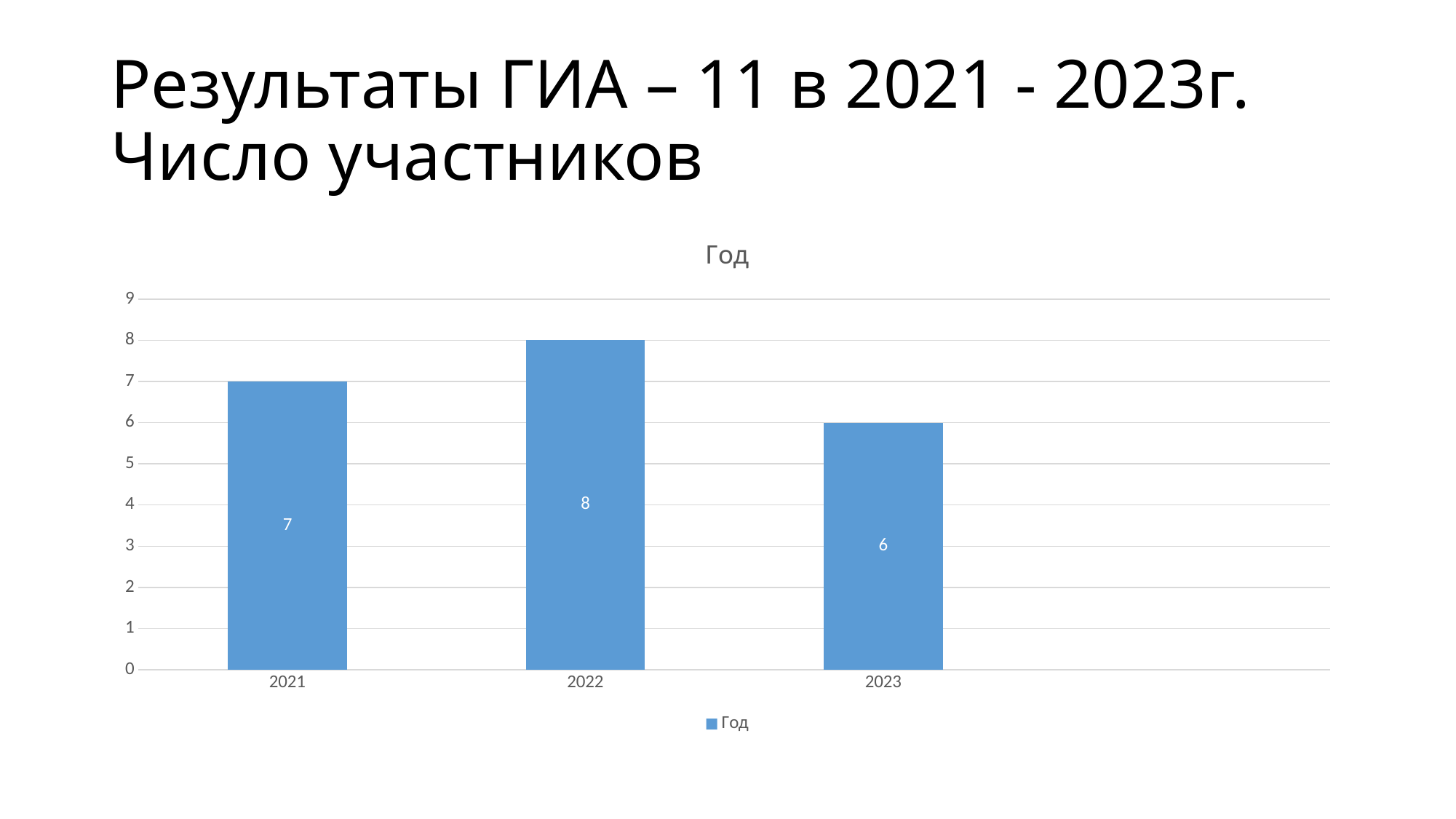
What is the difference between the values for 2022 and 2023? 2 What kind of chart is shown on the slide? bar chart Which year has the highest value? 2022 What is the title of the chart? Год How many series does the legend list? 1 How many years are shown on the x axis? 3 Which year has the lowest value? 2023 Is the value for 2022 greater or less than 5? greater What is the value for 2022? 8 What is the value for 2023? 6 What is the value for 2021? 7 Which is larger, the value for 2021 or the value for 2023? 2021